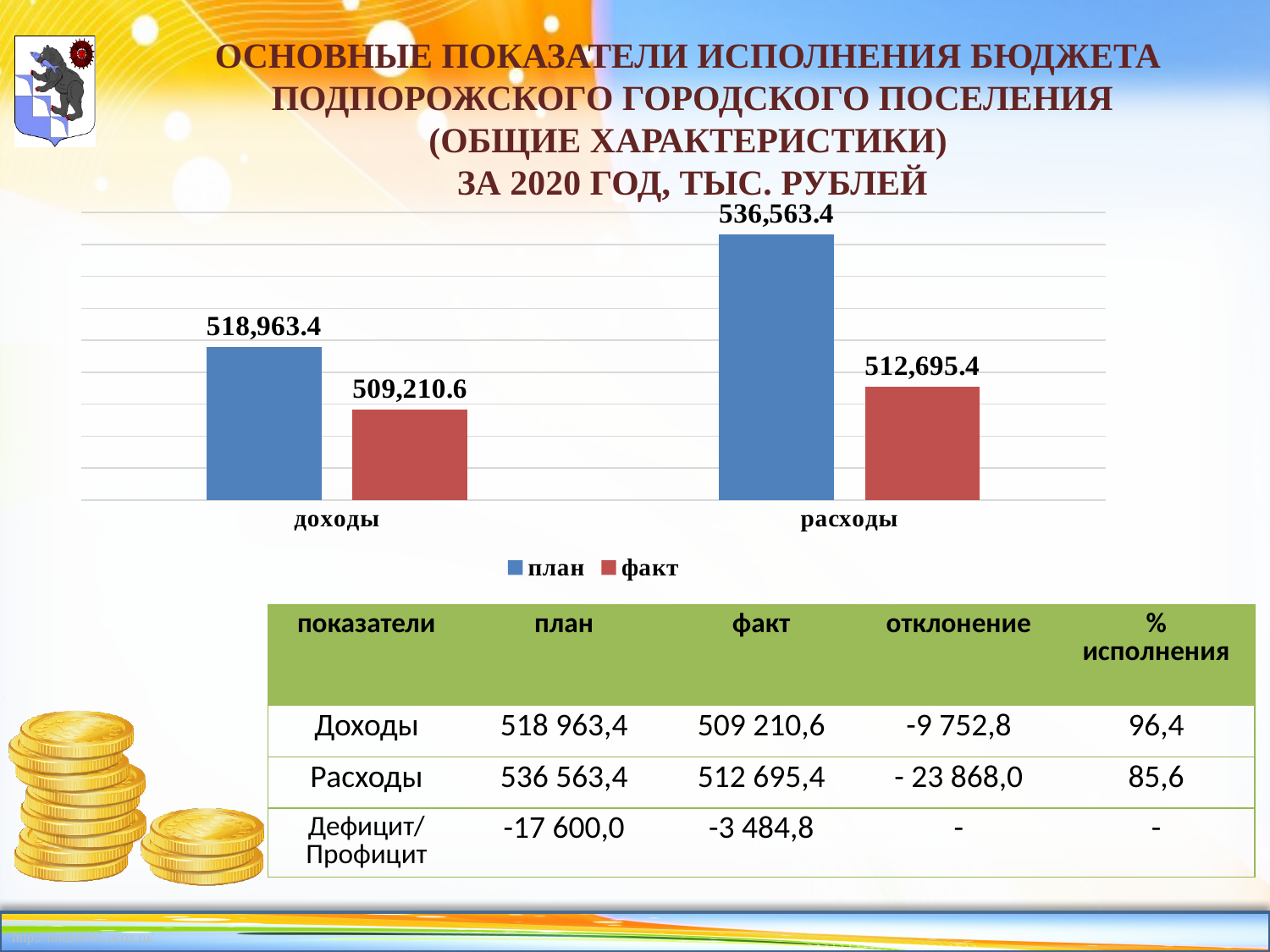
Which bar in the chart has the lowest value? факт for доходы What is the difference between the план and факт values for доходы? 9,752.8 What is the difference between the план and факт values for расходы? 23,868.0 How many series does the chart legend list? 2 Which is larger: the факт value for доходы or the факт value for расходы? факт for расходы What is the план value for доходы? 518,963.4 Which bar in the chart has the highest value? план for расходы What is the факт value for расходы? 512,695.4 What is the факт value for доходы? 509,210.6 How many categories are shown on the x axis of the chart? 2 What is the план value for расходы? 536,563.4 What type of chart is shown on the slide? bar chart